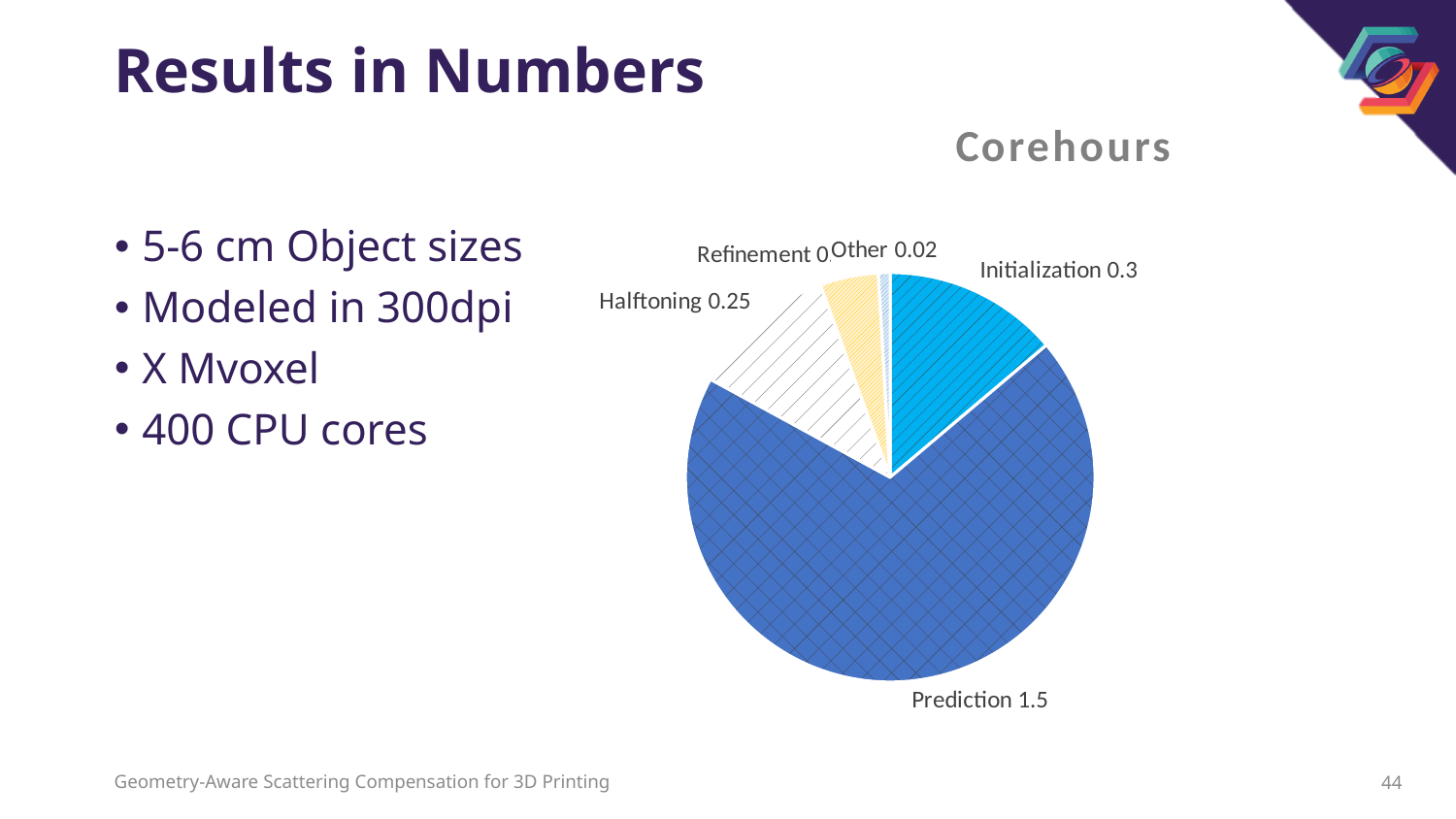
What is the value for Prediction in the Corehours pie chart? 1.5 What is the title of the chart on the slide? Corehours What is the value for Initialization in the Corehours pie chart? 0.3 How many slices does the Corehours pie chart have? 5 What is the difference between the Initialization and Halftoning values in the Corehours pie chart? 0.05 What kind of chart is shown on the slide? Pie chart What is the difference between the Prediction and Initialization values in the Corehours pie chart? 1.2 Which category has the largest slice in the Corehours pie chart? Prediction Which is larger in the Corehours pie chart, Initialization or Halftoning? Initialization What is the value for Other in the Corehours pie chart? 0.02 Which category has the smallest slice in the Corehours pie chart? Other What is the value for Halftoning in the Corehours pie chart? 0.25